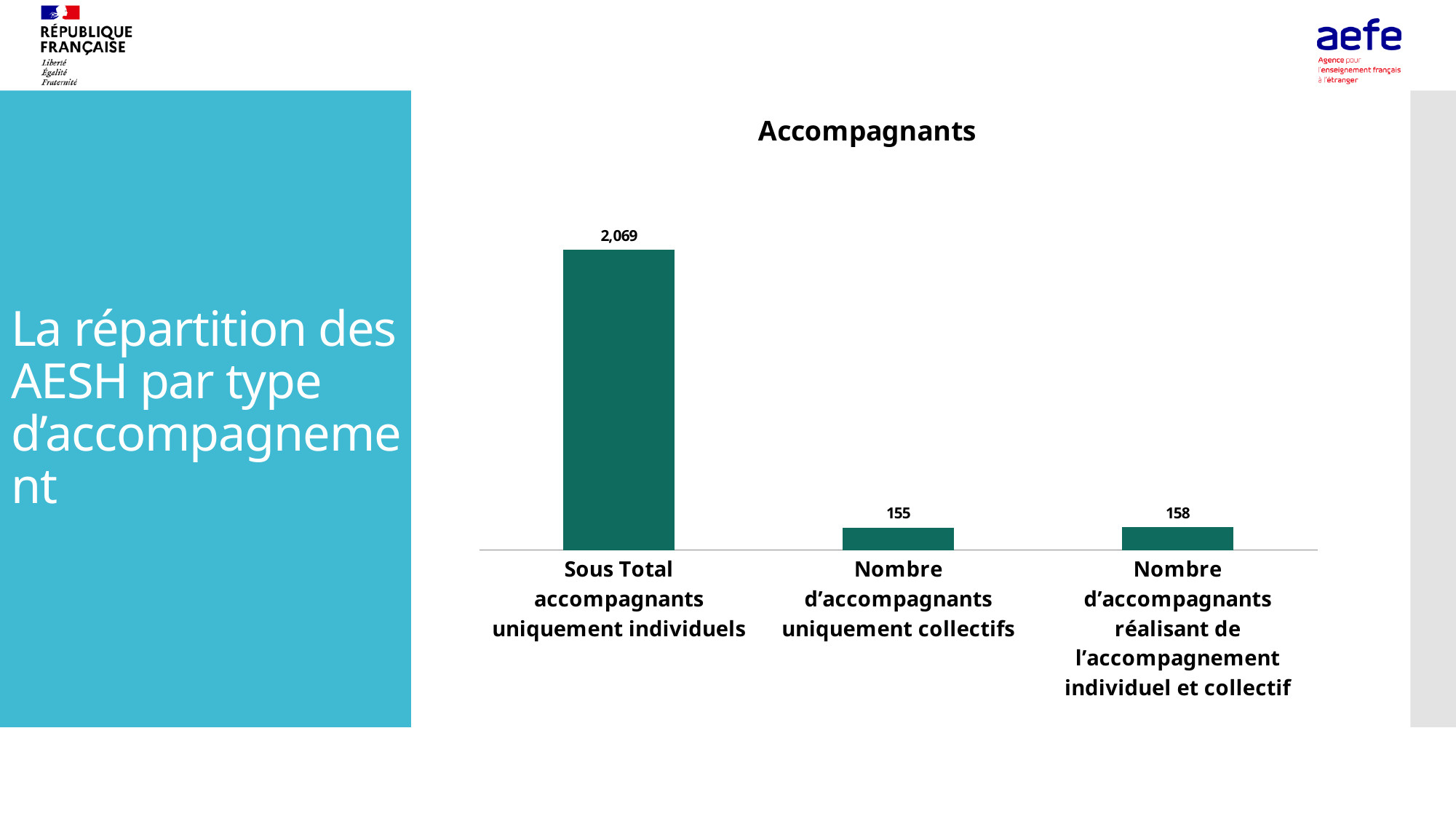
What is the difference between the value for 'Nombre d'accompagnants réalisant de l'accompagnement individuel et collectif' and the value for 'Nombre d'accompagnants uniquement collectifs'? 3 What is the value for 'Nombre d'accompagnants réalisant de l'accompagnement individuel et collectif'? 158 What kind of chart is shown on the slide? Bar chart Which is larger: the value for 'Nombre d'accompagnants uniquement collectifs' or the value for 'Nombre d'accompagnants réalisant de l'accompagnement individuel et collectif'? Nombre d'accompagnants réalisant de l'accompagnement individuel et collectif What is the title of the chart? Accompagnants How many categories are shown in the chart? 3 Which category has the highest value? Sous Total accompagnants uniquement individuels What colour are the bars in the chart? Dark green What is the difference between the value for 'Sous Total accompagnants uniquement individuels' and the value for 'Nombre d'accompagnants uniquement collectifs'? 1,914 Which category has the lowest value? Nombre d'accompagnants uniquement collectifs What is the value for 'Sous Total accompagnants uniquement individuels'? 2,069 What is the value for 'Nombre d'accompagnants uniquement collectifs'? 155